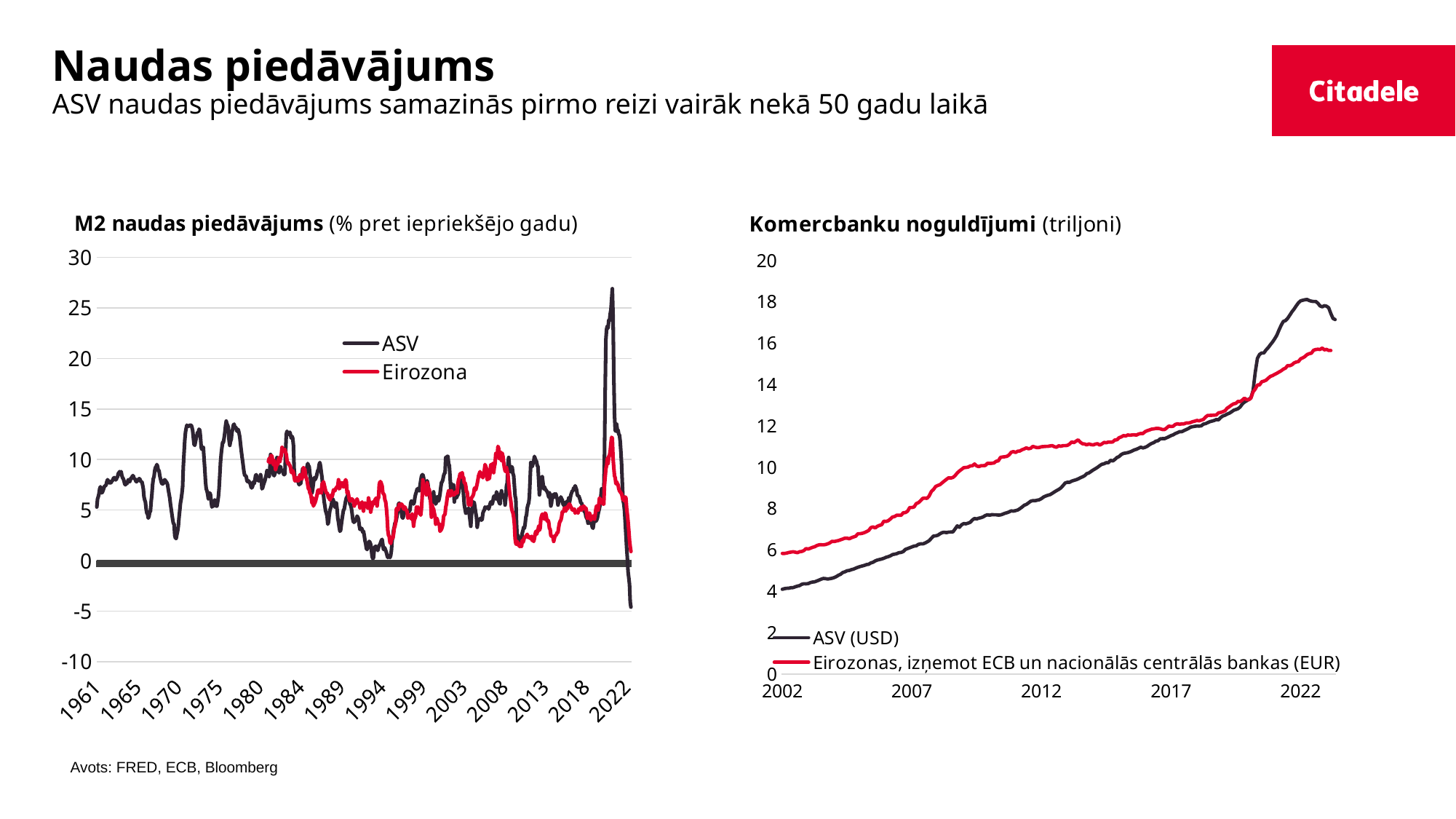
What kind of chart is the left chart titled "M2 naudas piedāvājums"? line chart In the right chart "Komercbanku noguldījumi", which series is higher in 2022, ASV (USD) or Eirozonas (EUR)? ASV (USD) In the left chart "M2 naudas piedāvājums", is the peak value of the ASV series around 2021 greater or less than 25? greater In the right chart "Komercbanku noguldījumi", do the values of the Eirozonas (EUR) series generally rise or fall from 2002 to 2022? rise In the right chart "Komercbanku noguldījumi", is the peak value of the ASV (USD) series greater or less than 16? greater In the left chart "M2 naudas piedāvājums", which series reaches the higher peak around 2021, ASV or Eirozona? ASV How many series does the legend of the left chart "M2 naudas piedāvājums" list? 2 In the left chart "M2 naudas piedāvājums", is the final value of the ASV series at the right end of the chart greater or less than 0? less In the right chart "Komercbanku noguldījumi", which series is higher in 2007, ASV (USD) or Eirozonas (EUR)? Eirozonas (EUR) What kind of chart is the right chart titled "Komercbanku noguldījumi"? line chart How many series does the legend of the right chart "Komercbanku noguldījumi" list? 2